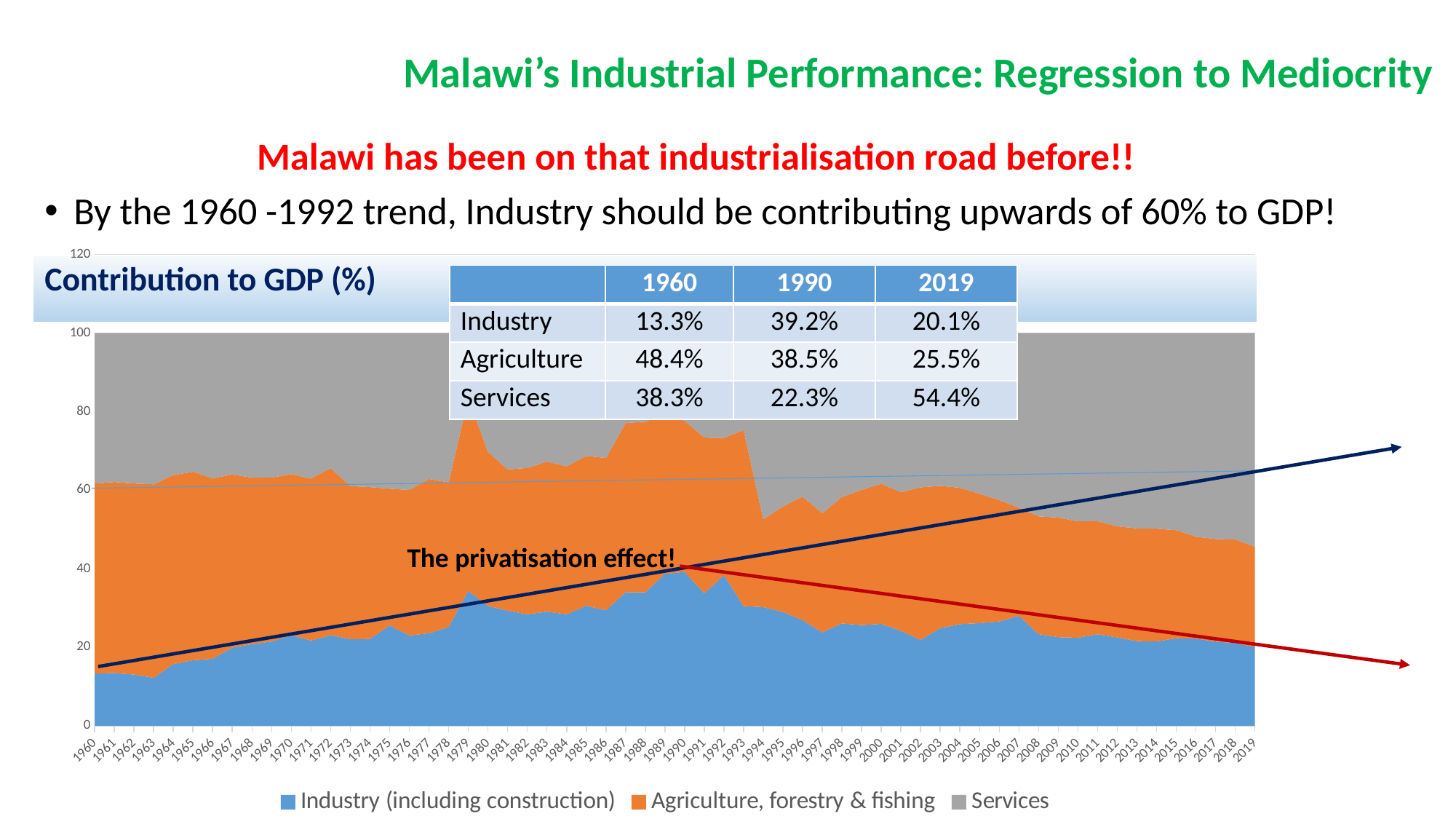
By how many percentage points did Industry's contribution to GDP change between 1990 and 2019, according to the table? 19.1 percentage points lower According to the table on the chart, what was Services' contribution to GDP in 2019? 54.4% According to the table on the chart, what was Industry's contribution to GDP in 1990? 39.2% In the table, which sector had the highest contribution to GDP in 1960? Agriculture According to the table on the chart, what was Agriculture's contribution to GDP in 1960? 48.4% What is the title of the chart? Contribution to GDP (%) In the table, which sector had the lowest contribution to GDP in 2019? Industry Which series is shown in orange in the chart? Agriculture, forestry & fishing How many series does the chart legend list? 3 According to the table, which was larger in 1990: Industry's or Agriculture's contribution to GDP? Industry Does the Industry (including construction) share rise or fall along the x axis from 1960 to 1990? Rise What kind of chart is shown on the slide? Stacked area chart